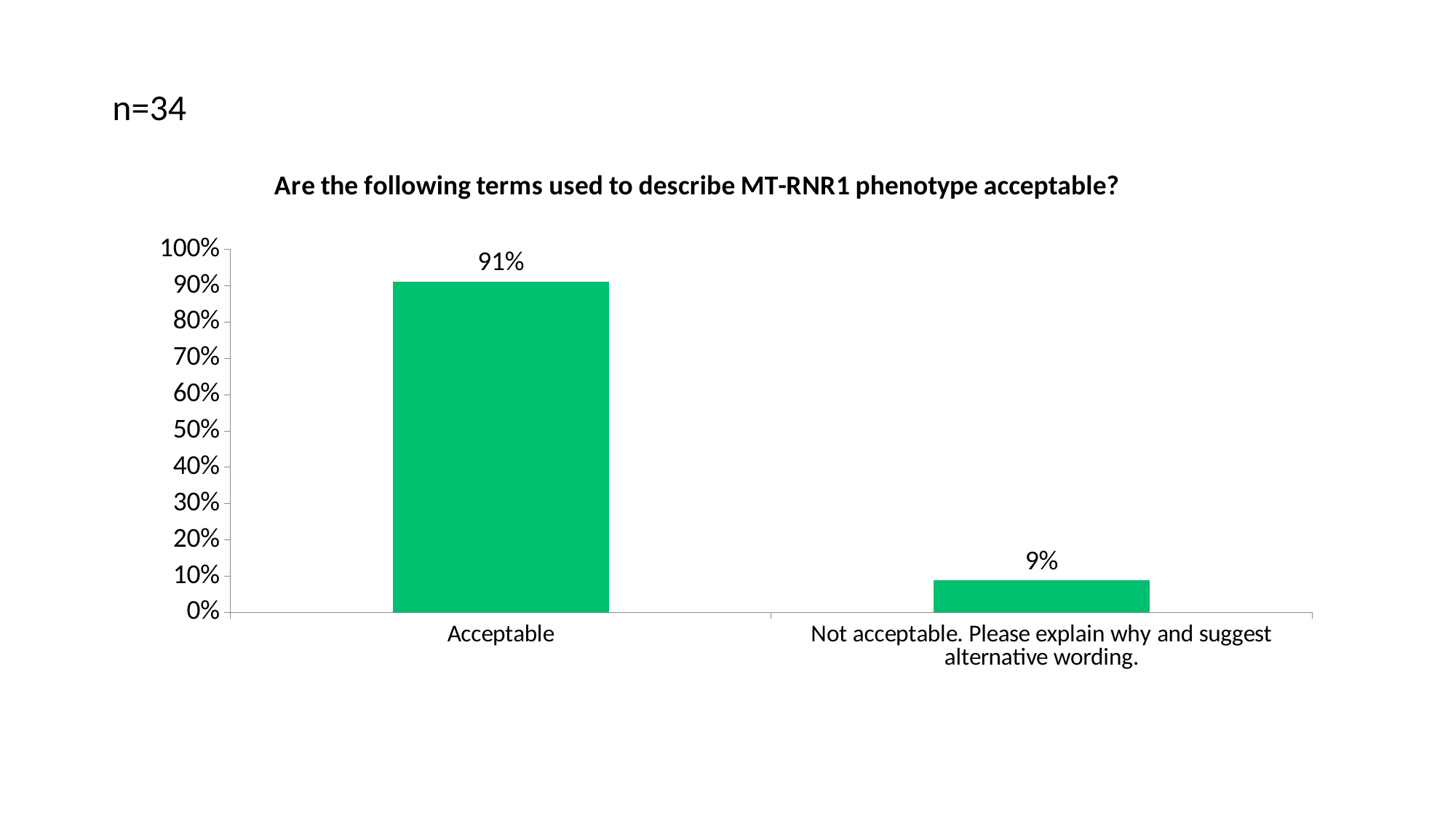
What percentage of respondents answered "Not acceptable. Please explain why and suggest alternative wording."? 9% What is the sample size (n) stated on the slide? n=34 Which is larger, the value for "Acceptable" or the value for "Not acceptable"? Acceptable How many categories are shown on the x axis? 2 Is the value for "Acceptable" greater or less than 50%? greater What is the title of the chart? Are the following terms used to describe MT-RNR1 phenotype acceptable? Which category has the lowest value? Not acceptable. Please explain why and suggest alternative wording. Which category has the highest value? Acceptable What kind of chart is shown on the slide? Bar chart Is the value for "Not acceptable" greater or less than 20%? less What is the difference between the "Acceptable" and "Not acceptable" percentages? 82% What percentage of respondents answered "Acceptable"? 91%